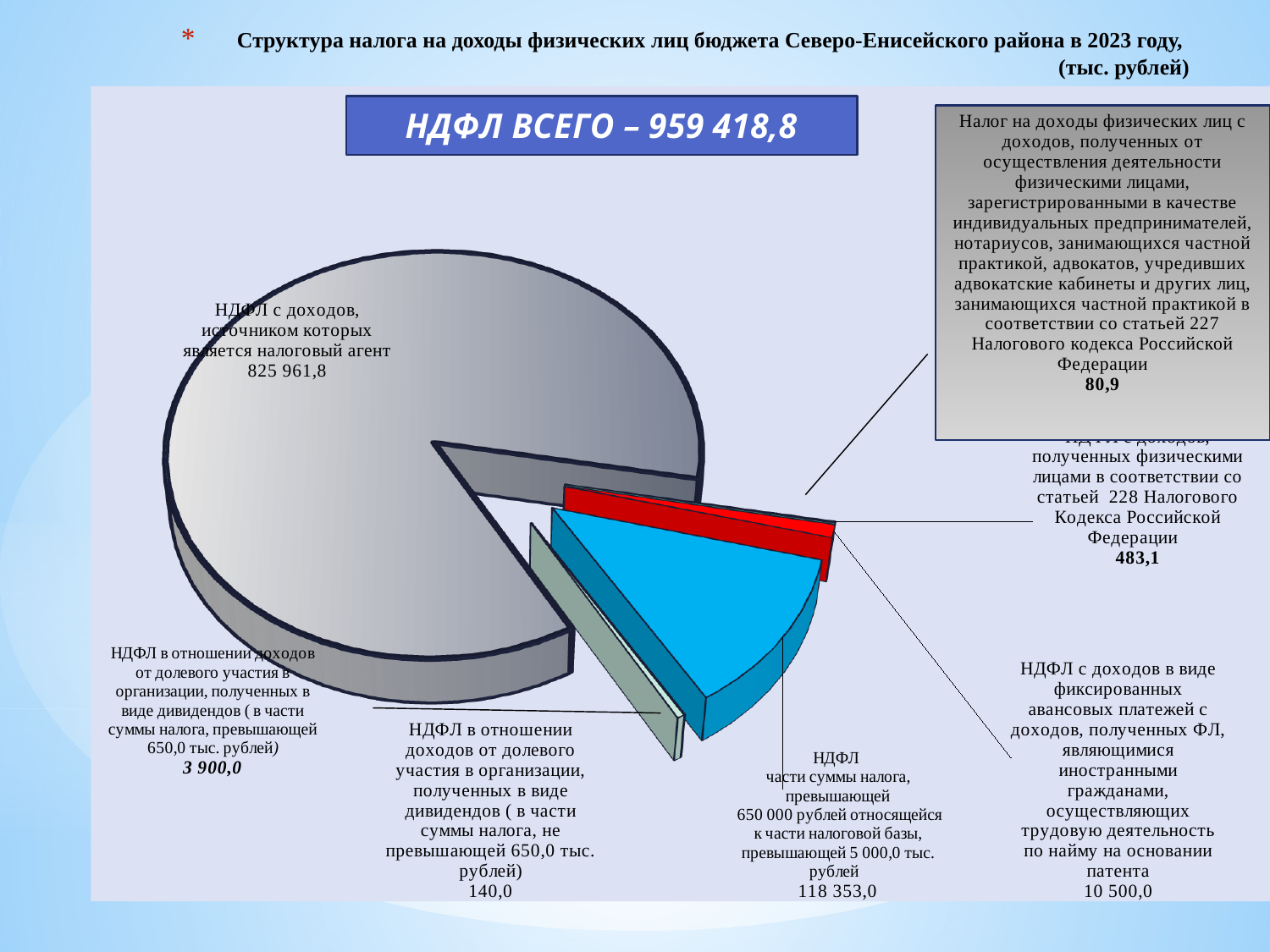
How many categories (slices) does the pie chart have? 7 What is the difference between the value for dividends exceeding 650,0 тыс. рублей (3 900,0) and dividends not exceeding 650,0 тыс. рублей (140,0)? 3 760,0 What is the value for НДФЛ части суммы налога, превышающей 650 000 рублей, относящейся к части налоговой базы, превышающей 5 000,0 тыс. рублей? 118 353,0 What is the value for НДФЛ с доходов, полученных физическими лицами в соответствии со статьей 228 Налогового Кодекса? 483,1 Which is larger: the value for статья 228 (483,1) or the value for статья 227 (80,9)? 483,1 (статья 228) What is the value for НДФЛ с доходов в виде фиксированных авансовых платежей (иностранные граждане, патент)? 10 500,0 Which category has the largest value in the pie chart? НДФЛ с доходов, источником которых является налоговый агент What is the total НДФЛ shown on the slide? 959 418,8 What is the value for НДФЛ с доходов, источником которых является налоговый агент? 825 961,8 What is the title of the slide? Структура налога на доходы физических лиц бюджета Северо-Енисейского района в 2023 году, (тыс. рублей) What kind of chart is shown on the slide? pie chart